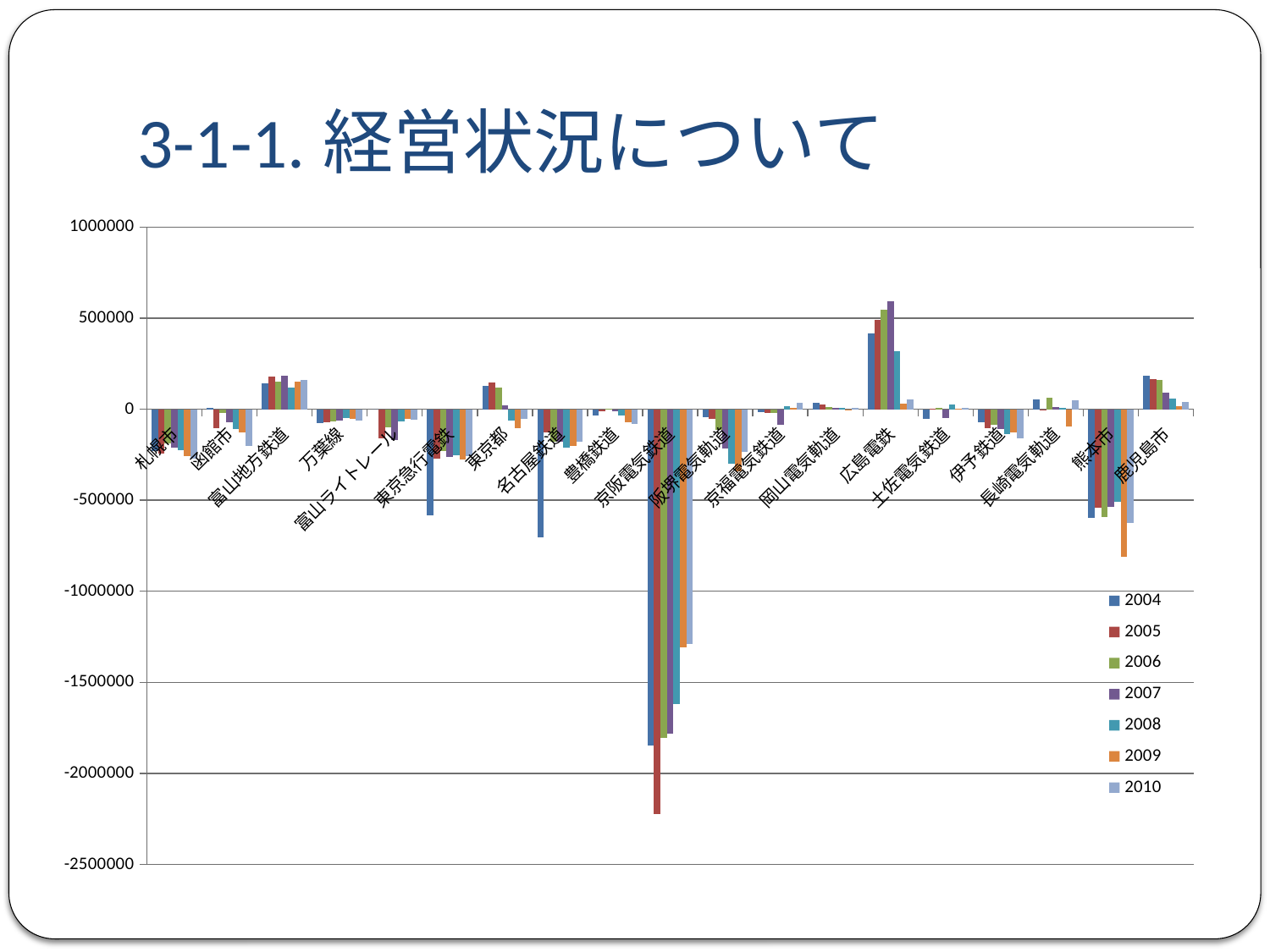
Which operator has the lowest (most negative) value in the chart? 京阪電気鉄道 How many operator categories are shown along the x axis? 19 What colour represents the 2005 series in the legend? red Is the 2007 value for 広島電鉄 greater or less than 500000? greater What kind of chart is shown on the slide? bar chart Is the 2004 value for 東京急行電鉄 greater or less than -500000? less Which operator has the highest positive values in the chart? 広島電鉄 How many series does the legend list? 7 Which is larger, the 2004 value for 広島電鉄 or the 2004 value for 鹿児島市? 広島電鉄 Which years does the legend cover, from first to last? 2004 to 2010 Is the 2005 value for 京阪電気鉄道 greater or less than -2000000? less